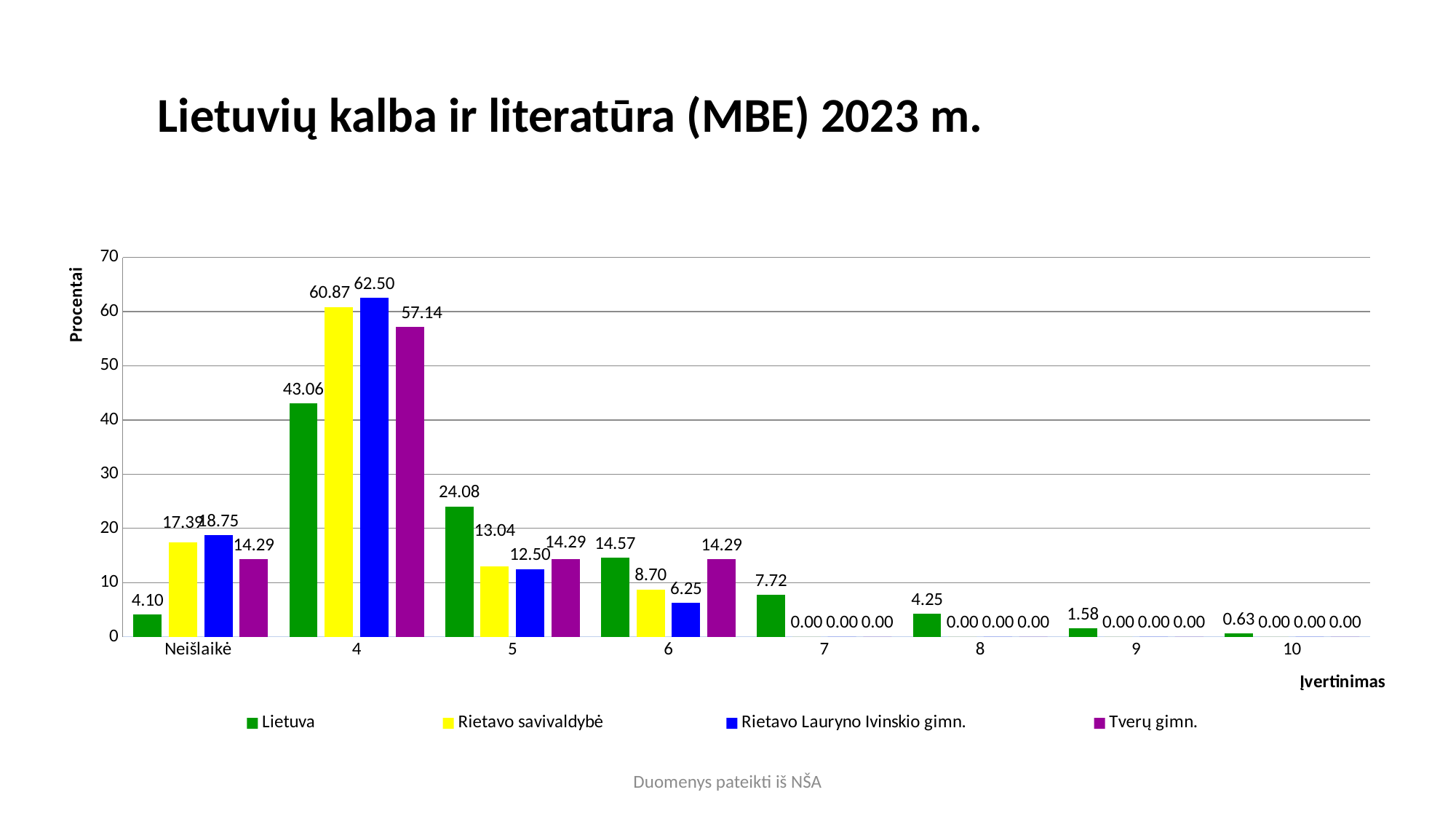
What is the value for Lietuva at category 4? 43.06 What is the value for Rietavo Lauryno Ivinskio gimn. at category 4? 62.50 At category 6, which is larger: the value for Lietuva or the value for Rietavo savivaldybė? Lietuva Which series has the highest value at category 4? Rietavo Lauryno Ivinskio gimn. What is the value for Tverų gimn. at category 5? 14.29 How many categories are shown on the x axis? 8 What is the value for Lietuva at category 10? 0.63 What kind of chart is shown on the slide? bar chart Which category has the highest value for Lietuva? 4 What is the difference between the Rietavo Lauryno Ivinskio gimn. value and the Tverų gimn. value at category 4? 5.36 Is the value for Rietavo savivaldybė at category 4 greater or less than 60? greater How many series does the legend list? 4